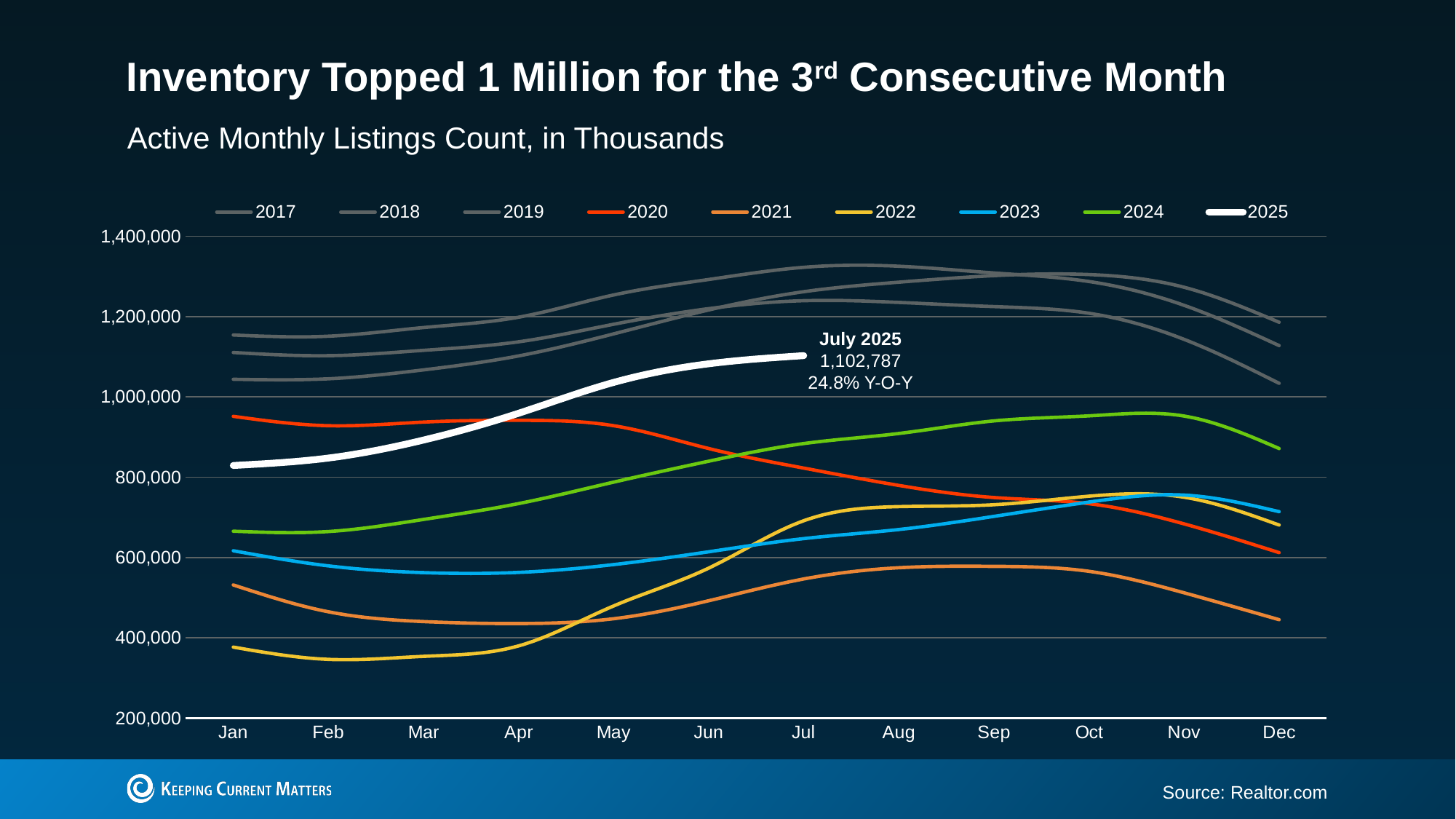
Is the value for 2022 in Feb greater or less than 400,000? less What kind of chart is shown on the slide? line chart What is the subtitle of the chart? Active Monthly Listings Count, in Thousands In Dec, which is larger: the value for 2024 or the value for 2020? 2024 Is the value for 2025 in Jan greater or less than 1,000,000? less Does the 2025 line rise or fall from Jan to Jul? rise What year-over-year change is labeled for July 2025? 24.8% Y-O-Y How many series does the legend list? 9 What is the active listings count for July 2025 shown on the chart? 1,102,787 Does the 2020 line rise or fall from May to Dec? fall Which series has the lowest value in Feb? 2022 How many months are shown along the x axis? 12